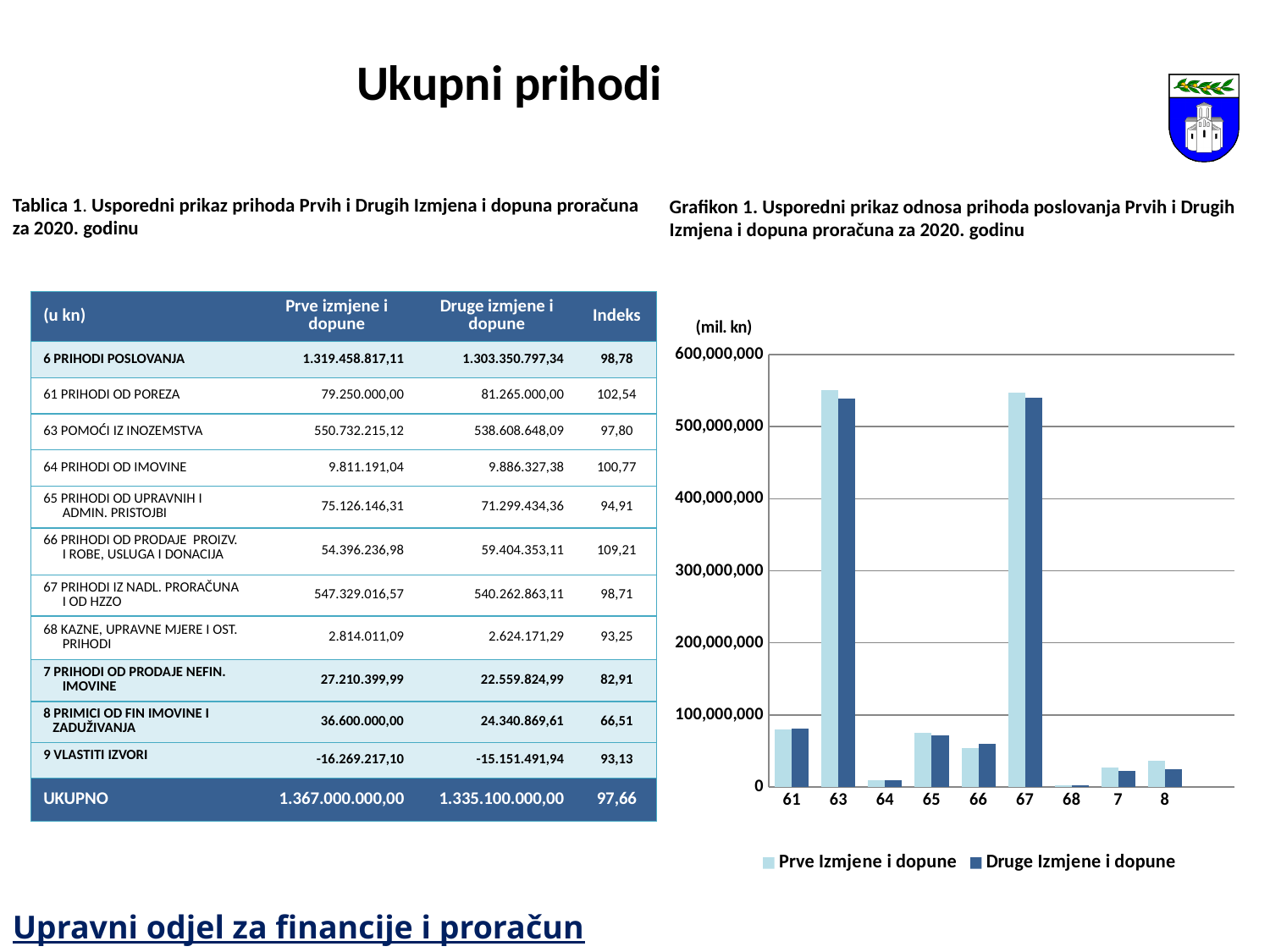
What are the two legend entries in Grafikon 1? Prve Izmjene i dopune; Druge Izmjene i dopune In Grafikon 1, is the value for category 61 in the Prve Izmjene i dopune series greater or less than 100,000,000? less In Grafikon 1, is the value for category 67 in the Druge Izmjene i dopune series greater or less than 500,000,000? greater In Grafikon 1, for category 8, which series has the larger bar: Prve Izmjene i dopune or Druge Izmjene i dopune? Prve Izmjene i dopune In Grafikon 1, which category has the lowest bars? 68 What kind of chart is Grafikon 1 on the slide? bar chart In Grafikon 1, which is larger in the Prve Izmjene i dopune series: category 65 or category 66? 65 How many series does the legend of Grafikon 1 list? 2 What unit label is shown above the y axis of Grafikon 1? (mil. kn) How many categories are shown on the x axis of Grafikon 1? 9 In Grafikon 1, is the value for category 64 in the Druge Izmjene i dopune series greater or less than 100,000,000? less